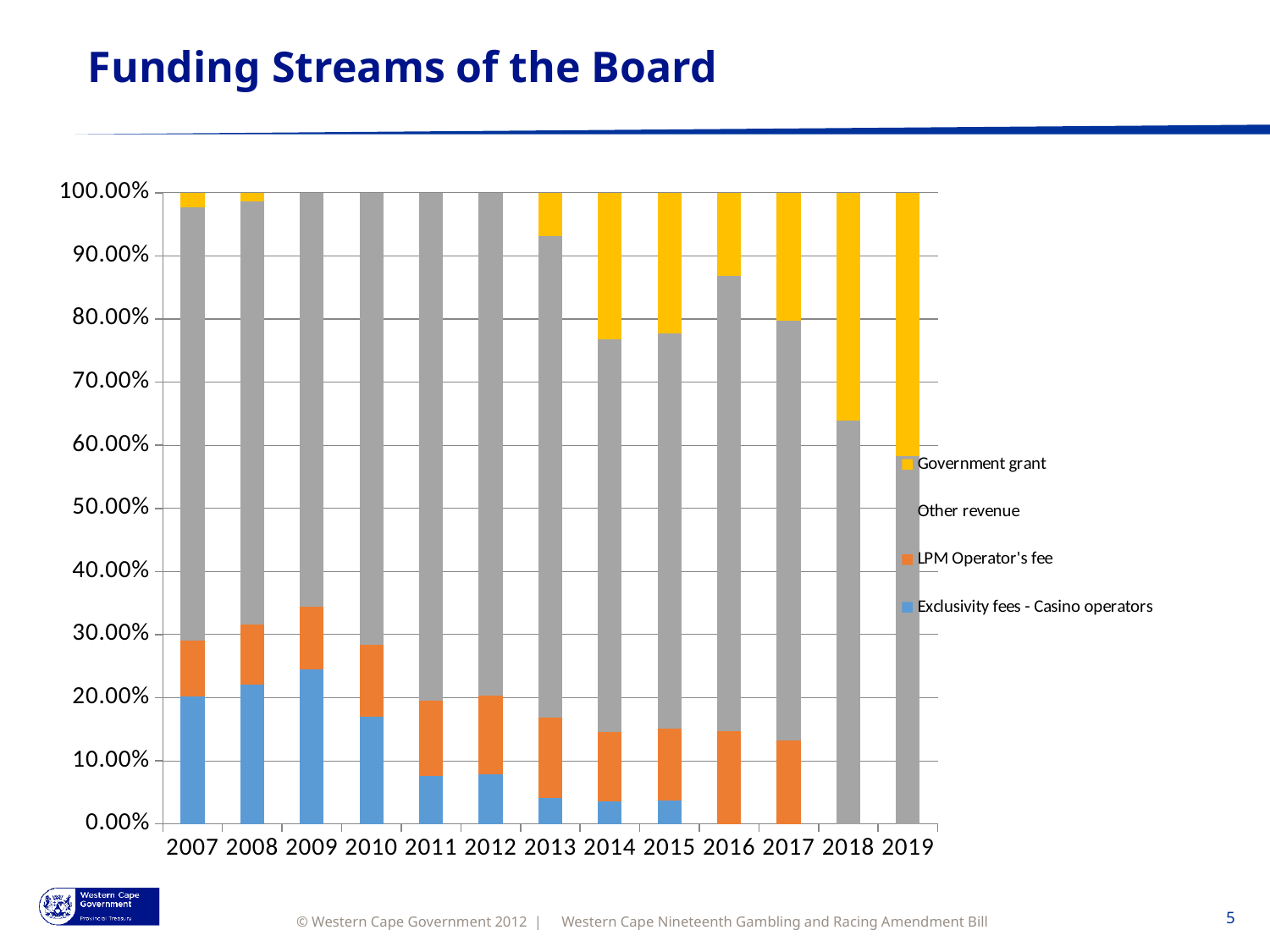
What kind of chart is shown on the slide? Stacked bar chart Is the Other revenue share in 2018 greater or less than 60.00%? greater Which year has the largest Government grant share? 2019 Is the Exclusivity fees - Casino operators share in 2009 greater or less than 20.00%? greater How many years are shown on the x axis of the chart? 13 Which year has the larger Government grant share, 2014 or 2016? 2014 Is the LPM Operator's fee share in 2017 greater or less than 10.00%? greater How many series does the chart's legend list? 4 Which year has the largest Exclusivity fees - Casino operators share? 2009 Does the Exclusivity fees - Casino operators share rise or fall from 2009 to 2019? Fall What colour represents Government grant in the chart? Yellow